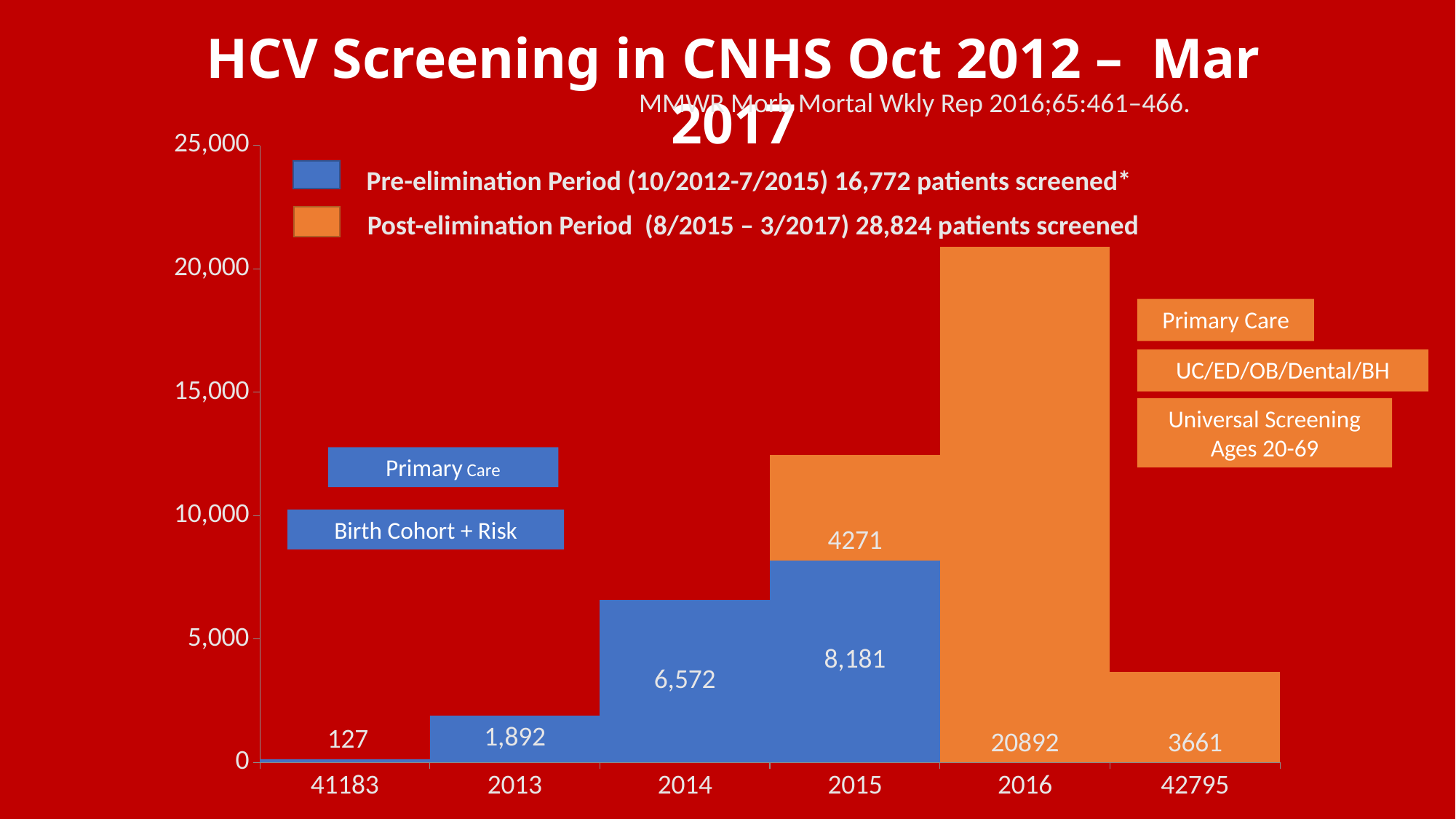
What kind of chart is shown on the slide? Stacked bar chart Which category has the lowest Pre-elimination Period value? 41183 What is the value of the Post-elimination Period series for 2016? 20892 Which category has the highest Post-elimination Period value? 2016 What is the difference between the Pre-elimination Period values for 2015 and 2014? 1,609 What is the value of the Pre-elimination Period series for 2013? 1,892 What is the value of the Pre-elimination Period series for 2014? 6,572 Which is larger: the Post-elimination Period value for 2015 or for 42795? 2015 How many series does the legend list? 2 What is the total of the stacked bar for 2015? 12,452 What is the value of the Post-elimination Period series for 2015? 4271 How many categories are shown on the x axis? 6